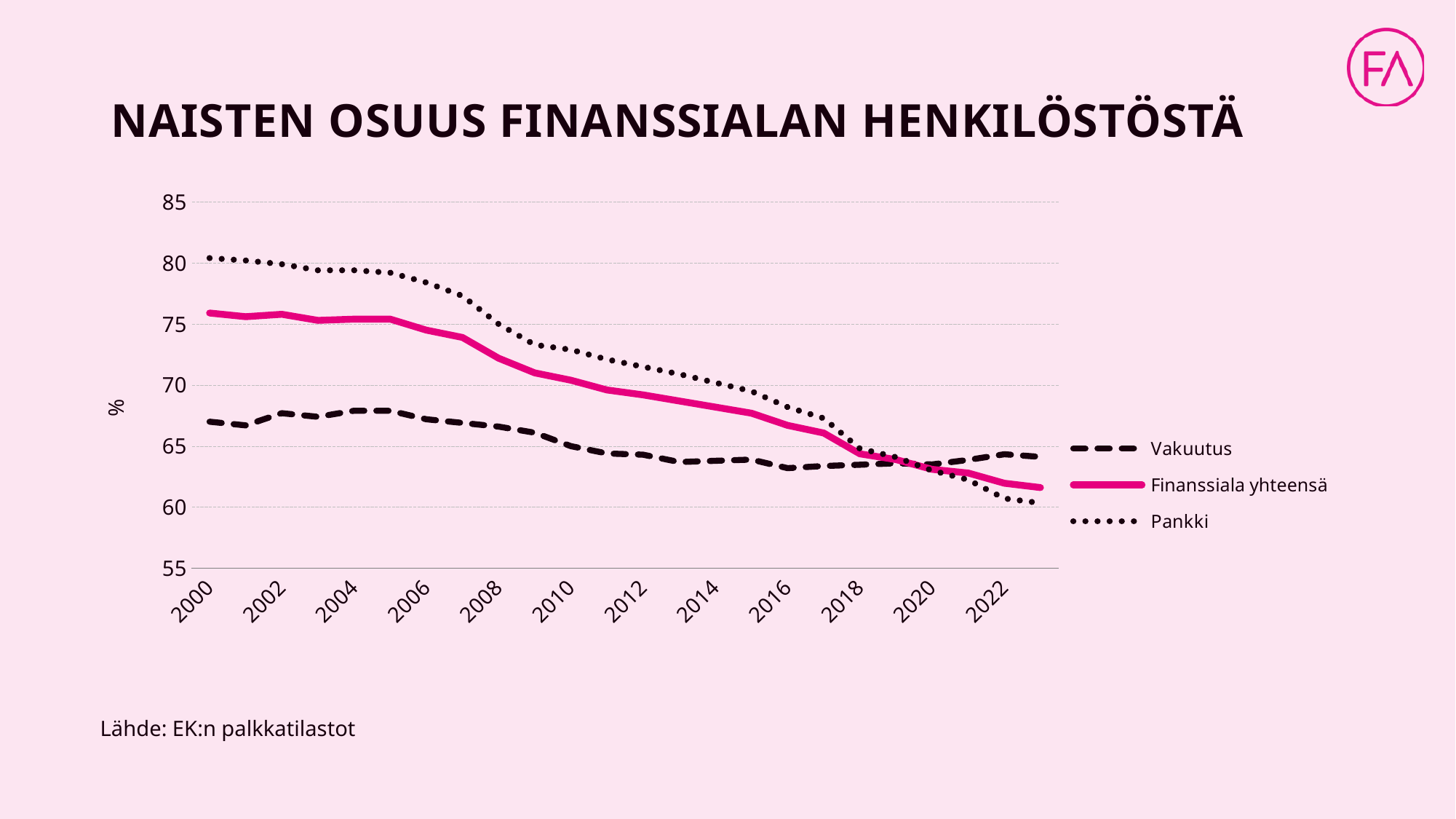
Is the value for Vakuutus in 2000 greater or less than 70? less Is the value for Pankki in 2022 greater or less than 65? less How many series does the legend list? 3 Which series has the lowest value in 2022? Pankki Which series has the highest value in 2000? Pankki Is the value for Pankki in 2000 greater or less than 75? greater What kind of chart is shown on the slide? line chart In 2010, which is higher: Finanssiala yhteensä or Vakuutus? Finanssiala yhteensä What is the title of the chart? NAISTEN OSUUS FINANSSIALAN HENKILÖSTÖSTÄ In 2022, which is higher: Vakuutus or Pankki? Vakuutus Does the Pankki series rise or fall from 2000 to 2022? fall